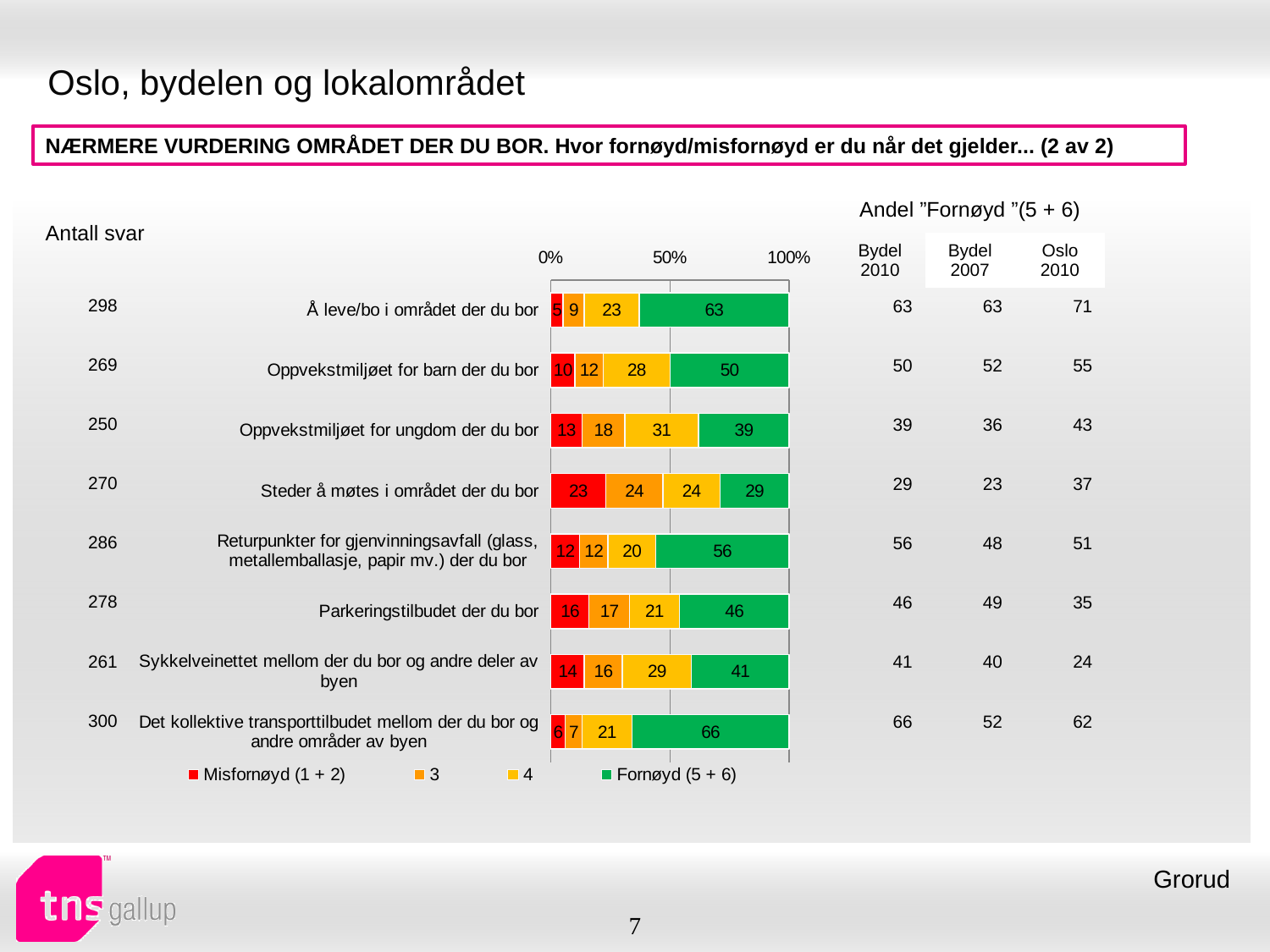
What kind of chart is shown on the slide? Stacked bar chart How many categories are shown in the chart? 8 What is the difference between the "Fornøyd (5 + 6)" values for "Parkeringstilbudet der du bor" and "Sykkelveinettet mellom der du bor og andre deler av byen"? 5 Which has a larger "Misfornøyd (1 + 2)" value: "Parkeringstilbudet der du bor" or "Oppvekstmiljøet for barn der du bor"? Parkeringstilbudet der du bor What is the value of the "4" segment for "Oppvekstmiljøet for ungdom der du bor"? 31 Which category has the lowest "Fornøyd (5 + 6)" value? Steder å møtes i området der du bor What is the value of the "Fornøyd (5 + 6)" segment for "Å leve/bo i området der du bor"? 63 Which category has the highest "Fornøyd (5 + 6)" value? Det kollektive transporttilbudet mellom der du bor og andre områder av byen How many series does the legend list? 4 What is the value of the "Misfornøyd (1 + 2)" segment for "Steder å møtes i området der du bor"? 23 Is the "Fornøyd (5 + 6)" value for "Returpunkter for gjenvinningsavfall (glass, metallemballasje, papir mv.) der du bor" greater or less than 50? greater What is the total of the stacked bar for "Oppvekstmiljøet for barn der du bor"? 100